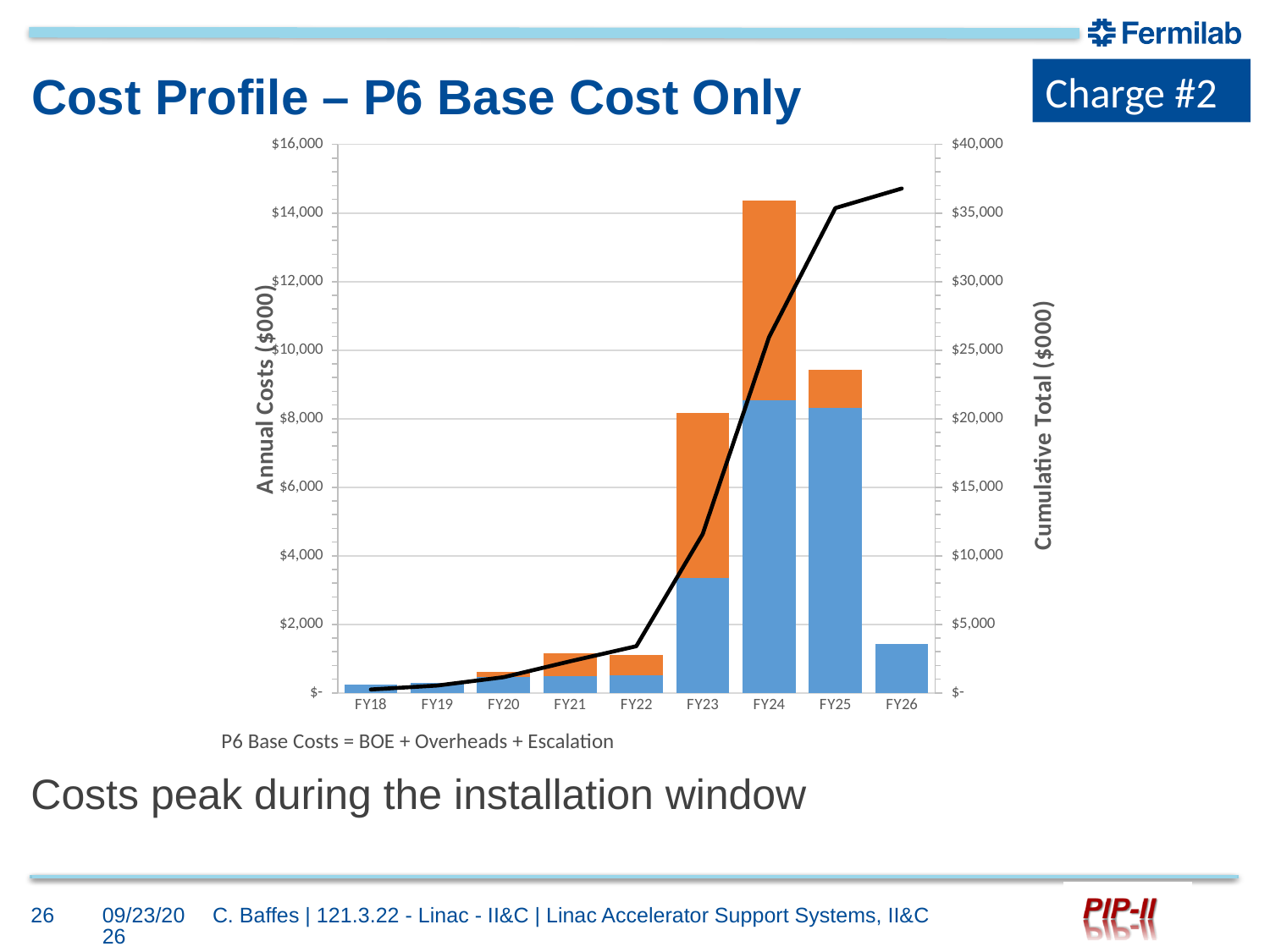
Is the total annual cost bar for FY24 greater or less than $12,000? greater Which fiscal year has the smallest stacked bar for annual costs? FY18 What is the title of the left vertical axis? Annual Costs ($000) How many fiscal years are shown on the x axis? 9 Which has the taller stacked bar, FY24 or FY25? FY24 What kind of chart is shown on the slide? bar chart (stacked) with a line Is the total annual cost bar for FY23 greater or less than $6,000? greater Does the cumulative total line rise or fall from FY18 to FY26? rises Is the cumulative total line at FY26 greater or less than $35,000? greater Which fiscal year has the tallest stacked bar for annual costs? FY24